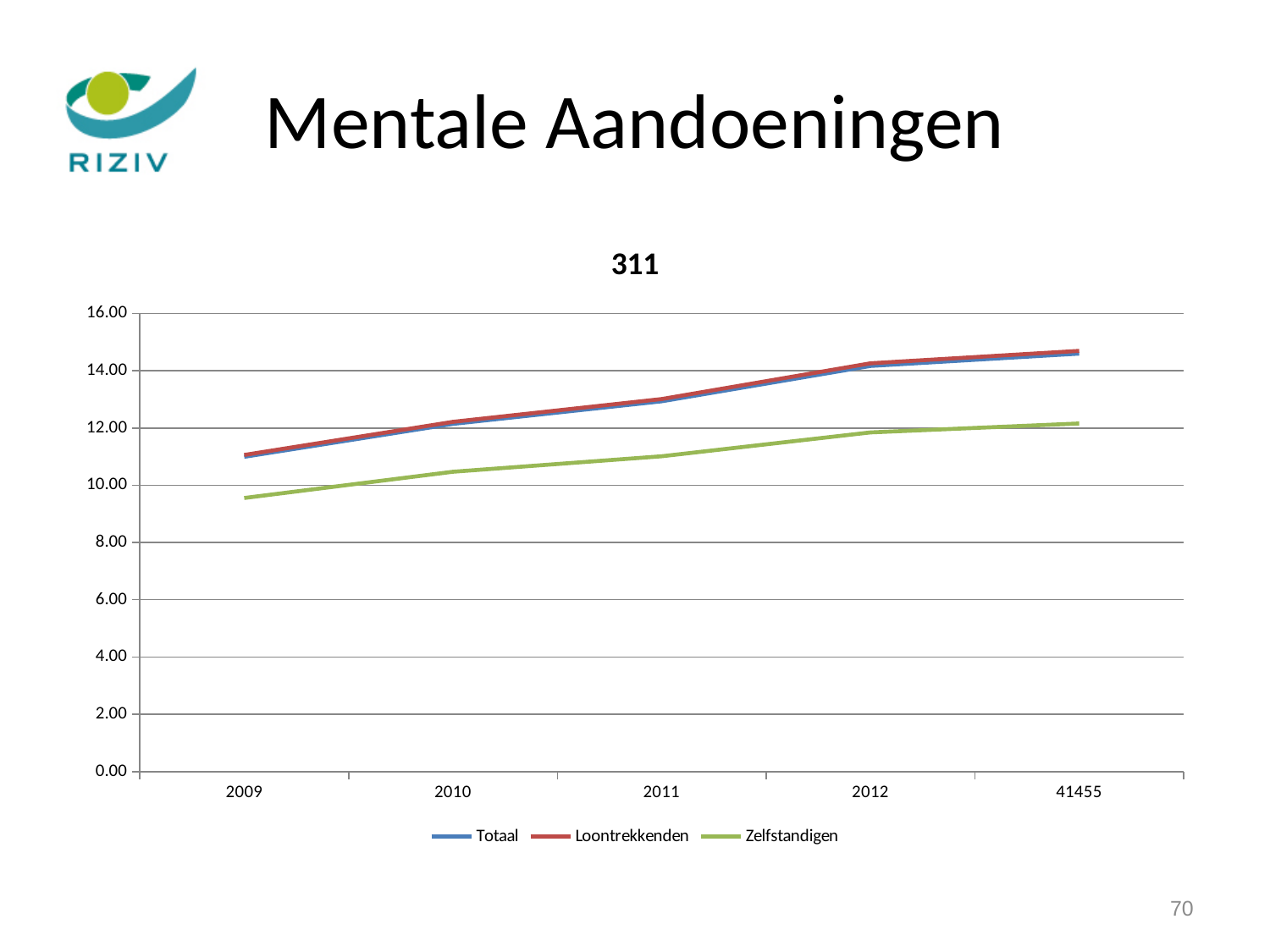
Is the value for Loontrekkenden in 2012 greater or less than 14.00? greater What is the title of the chart? 311 How many series does the legend list? 3 Which series is shown in green in the legend? Zelfstandigen How many points are plotted along the x axis for each series? 5 What kind of chart is shown on the slide? line chart Do the values for Loontrekkenden rise or fall along the x axis? rise Is the value for Totaal in 2009 greater or less than 12.00? less In which year is the value for Zelfstandigen lowest? 2009 Do the values for Zelfstandigen rise or fall from 2009 to 41455? rise In 2011, which is larger: the value for Loontrekkenden or the value for Zelfstandigen? Loontrekkenden Is the value for Zelfstandigen in 2009 greater or less than 10.00? less